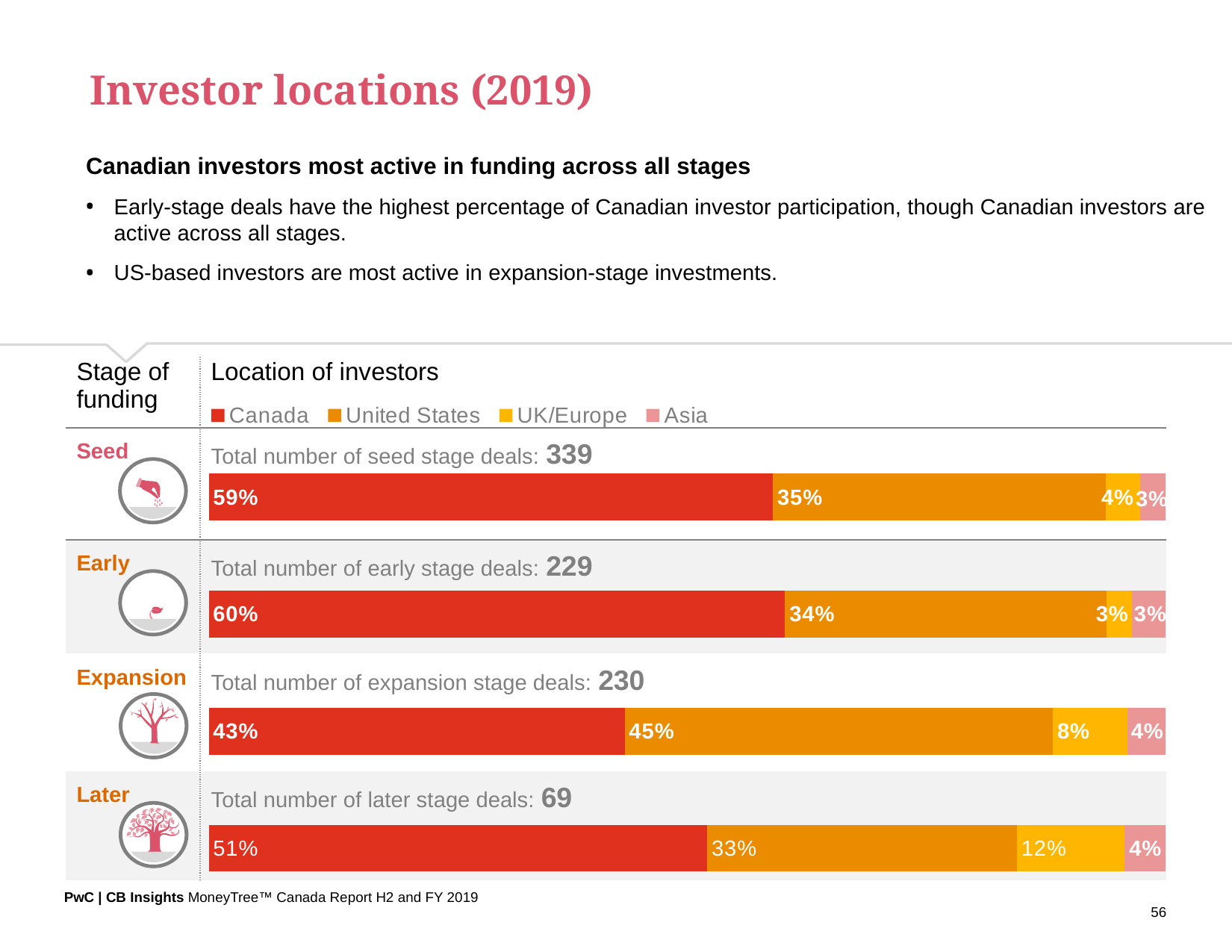
Which stage of funding has the lowest percentage of Canadian investors? Expansion What percentage of expansion stage investors are from the United States? 45% Which colour represents Asia in the chart? Pink What percentage of seed stage investors are from Canada? 59% Which stage of funding has the highest percentage of Canadian investors? Early What kind of chart is used to show the location of investors? Stacked bar chart What is the difference between the Canada and United States percentages for seed stage deals? 24% How many investor locations does the legend list? 4 For expansion stage deals, which is larger: the Canada share or the United States share? United States What percentage of later stage investors are from UK/Europe? 12% What is the total number of early stage deals shown? 229 How many stages of funding are shown in the chart? 4